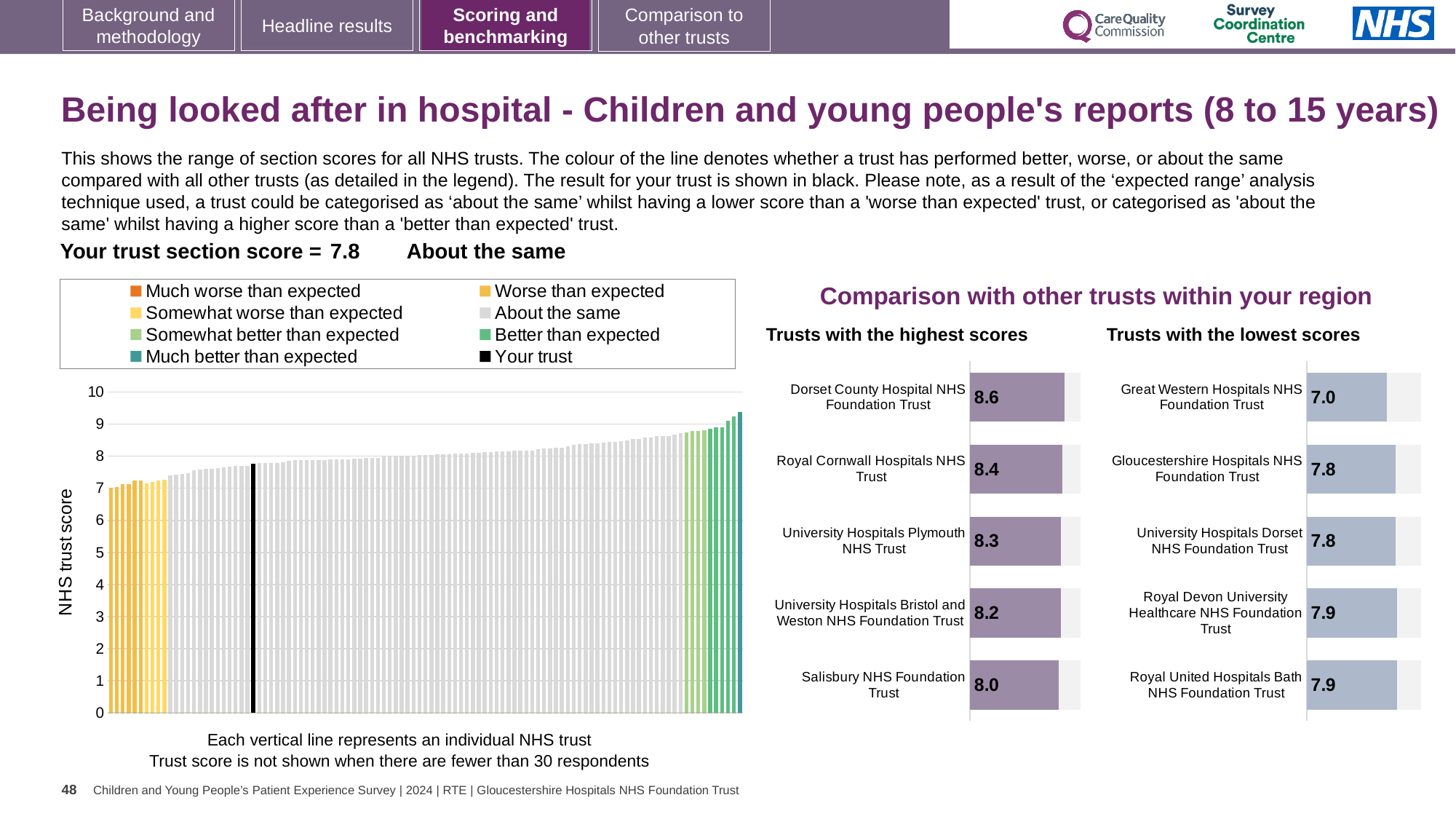
In the 'Trusts with the lowest scores' chart, which trust has the lowest score? Great Western Hospitals NHS Foundation Trust What kind of chart is the large chart on the left showing NHS trust scores? bar chart In the 'Trusts with the lowest scores' chart, what is the difference between the scores of Royal Devon University Healthcare NHS Foundation Trust and Great Western Hospitals NHS Foundation Trust? 0.9 In the large chart on the left, do the trust scores rise or fall from left to right? rise How many entries does the legend above the large chart on the left list? 8 In the large chart on the left, what is the section score for your trust (the black bar)? 7.8 How many trusts are shown in the 'Trusts with the highest scores' chart? 5 In the 'Trusts with the highest scores' chart, what is the difference between the scores of Dorset County Hospital NHS Foundation Trust and Salisbury NHS Foundation Trust? 0.6 In the 'Trusts with the highest scores' chart, which has the larger score: Royal Cornwall Hospitals NHS Trust or University Hospitals Plymouth NHS Trust? Royal Cornwall Hospitals NHS Trust In the 'Trusts with the lowest scores' chart, what is the score for Great Western Hospitals NHS Foundation Trust? 7.0 In the 'Trusts with the highest scores' chart, what is the score for Dorset County Hospital NHS Foundation Trust? 8.6 In the 'Trusts with the highest scores' chart, which trust has the highest score? Dorset County Hospital NHS Foundation Trust